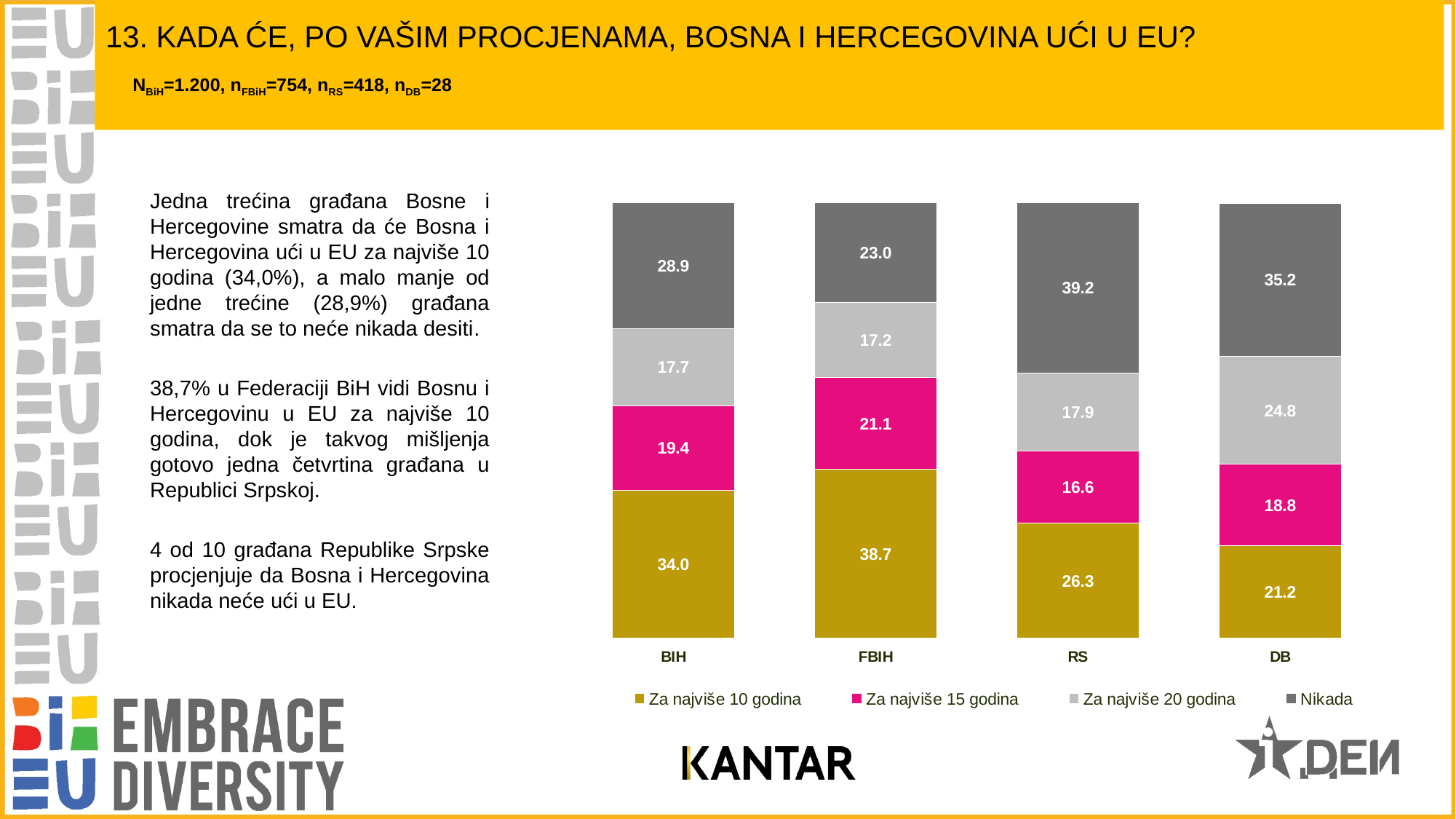
What is the value for "Za najviše 20 godina" in the DB bar? 24.8 What is the value for "Za najviše 15 godina" in the BIH bar? 19.4 What is the total of the stacked bar for DB? 100.0 Which is larger: the "Nikada" value for BIH or for FBIH? BIH Which category has the lowest value for "Za najviše 10 godina"? DB What is the difference between the "Za najviše 10 godina" values for FBIH and RS? 12.4 How many categories are shown on the x axis? 4 Which category has the highest value for "Nikada"? RS What kind of chart is shown on the slide? Stacked bar chart What is the value for "Nikada" in the RS bar? 39.2 How many series does the legend list? 4 What is the value for "Za najviše 10 godina" in the FBIH bar? 38.7